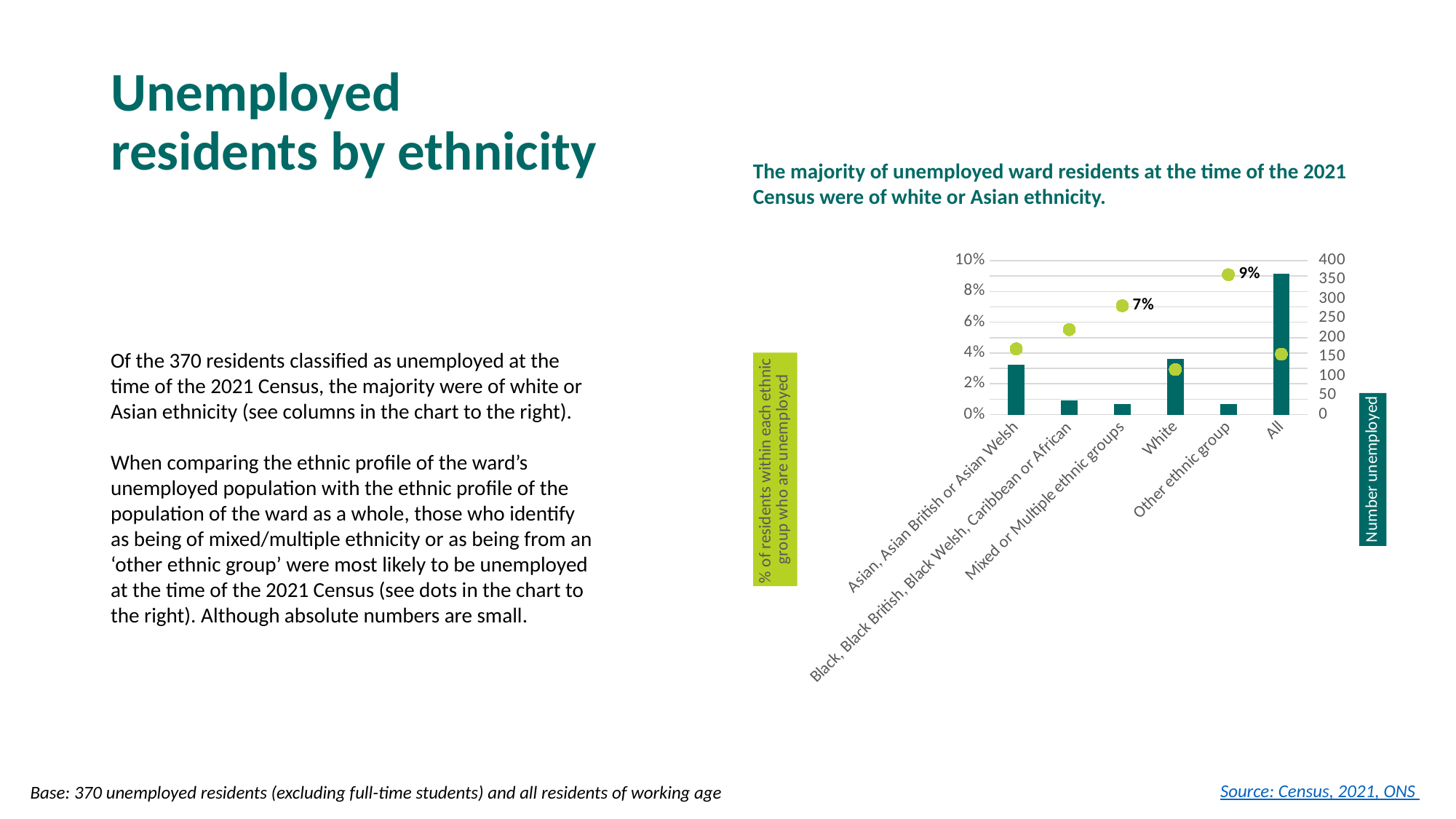
How many categories are shown on the x axis of the chart? 6 What is the label of the right-hand vertical axis of the chart? Number unemployed Is the number unemployed bar for All greater or less than 300? greater What percentage of residents in the Other ethnic group category are unemployed, according to the dot label? 9% Which has a taller number unemployed bar: White or Asian, Asian British or Asian Welsh? White What percentage of residents in the Mixed or Multiple ethnic groups category are unemployed, according to the dot label? 7% Is the number unemployed bar for Asian, Asian British or Asian Welsh greater or less than 200? less What is the difference between the unemployment percentage for Other ethnic group and for Mixed or Multiple ethnic groups? 2% Which category has the tallest bar for number unemployed? All Is the number unemployed bar for White greater or less than 100? greater Which ethnic group has the highest percentage of residents who are unemployed (the highest dot)? Other ethnic group Which has a higher unemployment percentage: Mixed or Multiple ethnic groups, or Other ethnic group? Other ethnic group